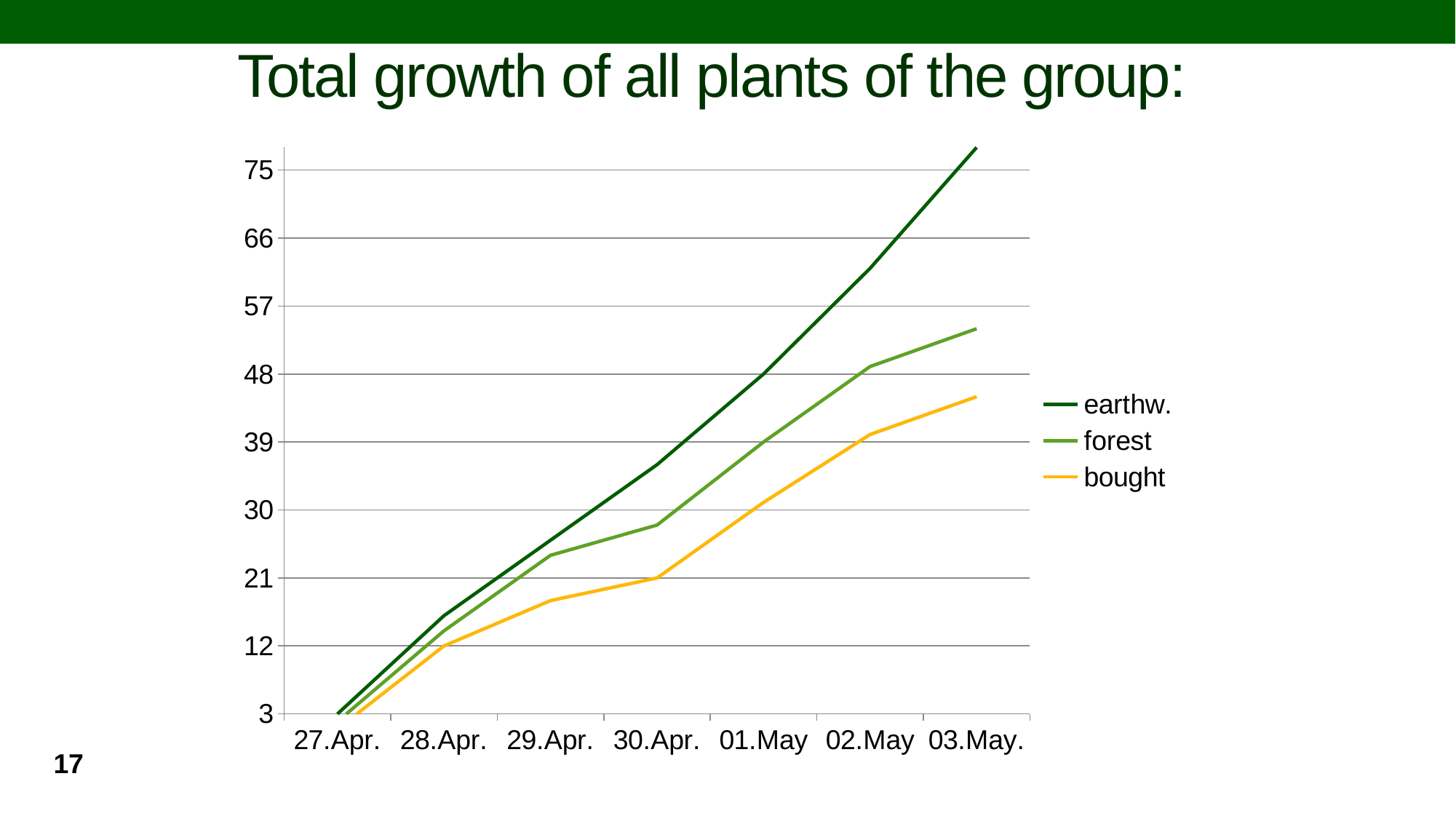
What kind of chart is shown on the slide? line chart Is the value for bought on 03.May. greater or less than 48? less How many dates are shown along the x axis? 7 Is the value for forest on 03.May. greater or less than 57? less How many series does the legend list? 3 Do the values for the earthw. series rise or fall from 27.Apr. to 03.May.? rise Which series has the lowest value on 03.May.? bought Is the value for earthw. on 30.Apr. greater or less than 30? greater Which series has the highest value on 03.May.? earthw. What is the title of the chart? Total growth of all plants of the group: Which is larger on 02.May, the value for forest or the value for bought? forest